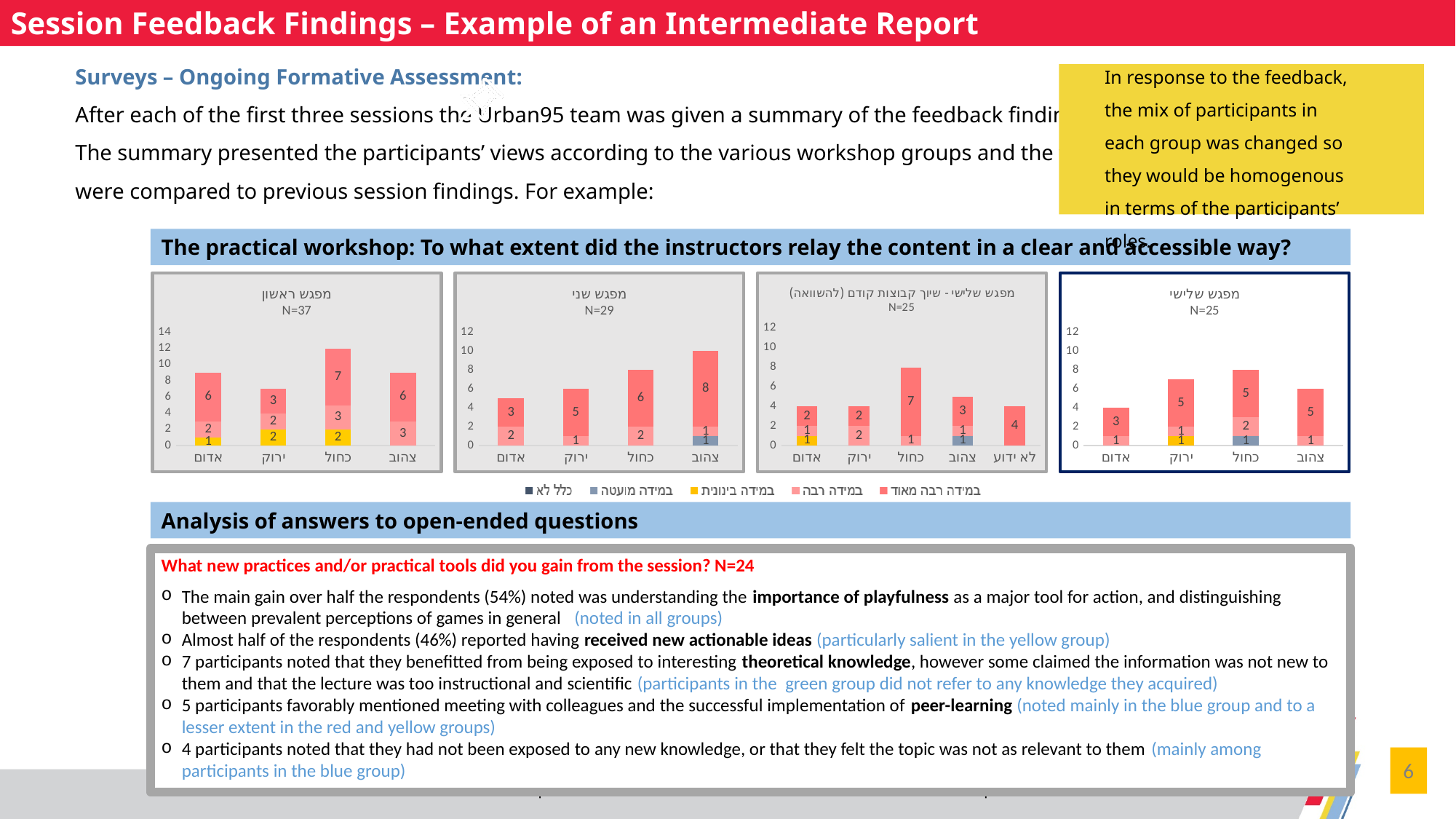
In the leftmost chart (מפגש ראשון), what is the value of the top (במידה רבה מאוד) segment for אדום? 6 In the rightmost chart (מפגש שלישי, N=25), which is larger: the stacked bar for ירוק or the stacked bar for אדום? ירוק In the rightmost chart (מפגש שלישי, N=25), what is the total of the stacked bar for כחול? 8 How many series does the shared legend below the charts list? 5 In the leftmost chart (מפגש ראשון), which category has the tallest stacked bar? כחול In the leftmost chart (מפגש ראשון, N=37), what is the total height of the stacked bar for כחול? 12 In the second chart from the left (מפגש שני), which category has the shortest stacked bar? אדום How many categories are shown on the x axis of the third chart from the left (מפגש שלישי - שיוך קבוצות קודם)? 5 In the third chart from the left (מפגש שלישי - שיוך קבוצות קודם), what is the value of the top segment for כחול? 7 In the second chart from the left (מפגש שני), what is the value of the top segment for ירוק? 5 In the second chart from the left (מפגש שני, N=29), what is the total of the stacked bar for צהוב? 10 In the rightmost chart (מפגש שלישי, N=25), what is the difference between the top segment for ירוק and the top segment for אדום? 2